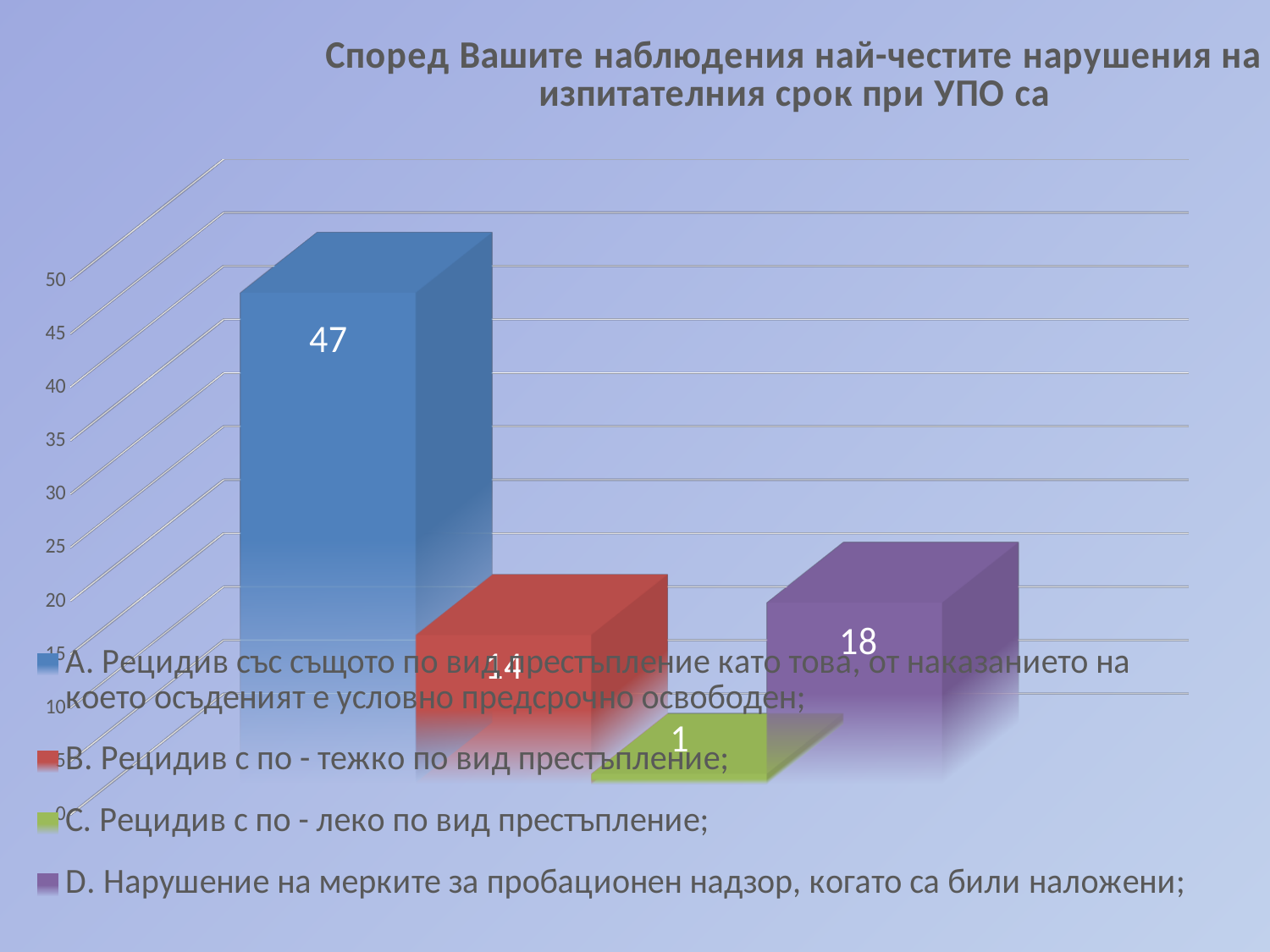
What value is shown for category C (Рецидив с по - леко по вид престъпление)? 1 Is the value for category A greater or less than 40? greater What colour is the bar for category D? purple Which is larger, the value for category D or the value for category B? D How many categories are plotted in the chart? 4 What kind of chart is shown on the slide? bar chart What value is shown for category A (Рецидив със същото по вид престъпление)? 47 What value is shown for category B (Рецидив с по - тежко по вид престъпление)? 14 Which category has the highest value? A. Рецидив със същото по вид престъпление What is the difference between the values for category A and category D? 29 What value is shown for category D (Нарушение на мерките за пробационен надзор)? 18 Which category has the lowest value? C. Рецидив с по - леко по вид престъпление